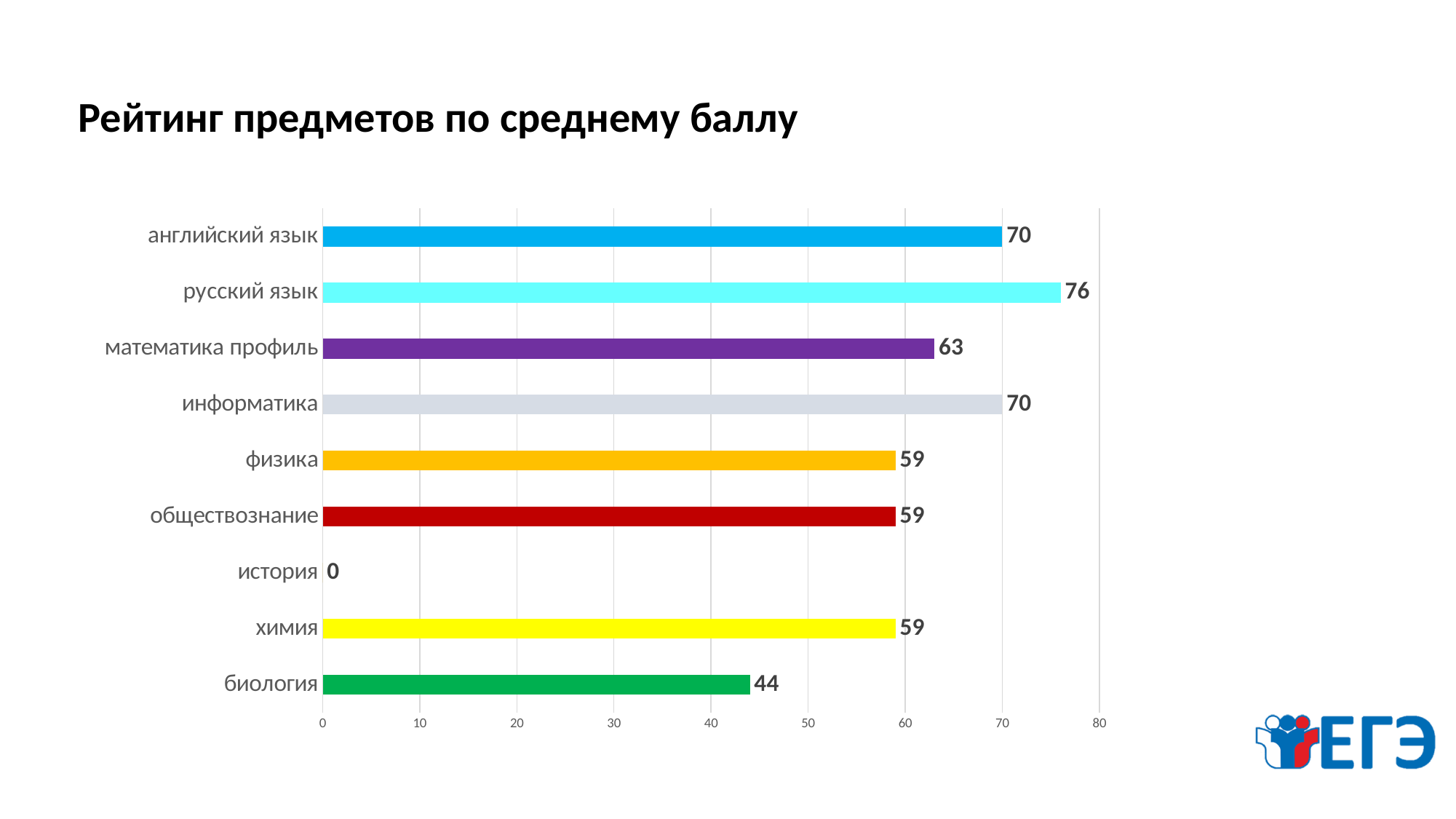
What is the difference between the values for русский язык and биология? 32 Which subject has the lowest average score? история What kind of chart is shown on the slide? bar chart Which subject has the highest average score? русский язык How many subjects are shown on the chart? 9 What is the value for русский язык? 76 Which is larger, the value for английский язык or the value for математика профиль? английский язык What is the value for математика профиль? 63 What is the title of the chart? Рейтинг предметов по среднему баллу What is the value for биология? 44 What is the difference between the values for математика профиль and физика? 4 What is the value for история? 0